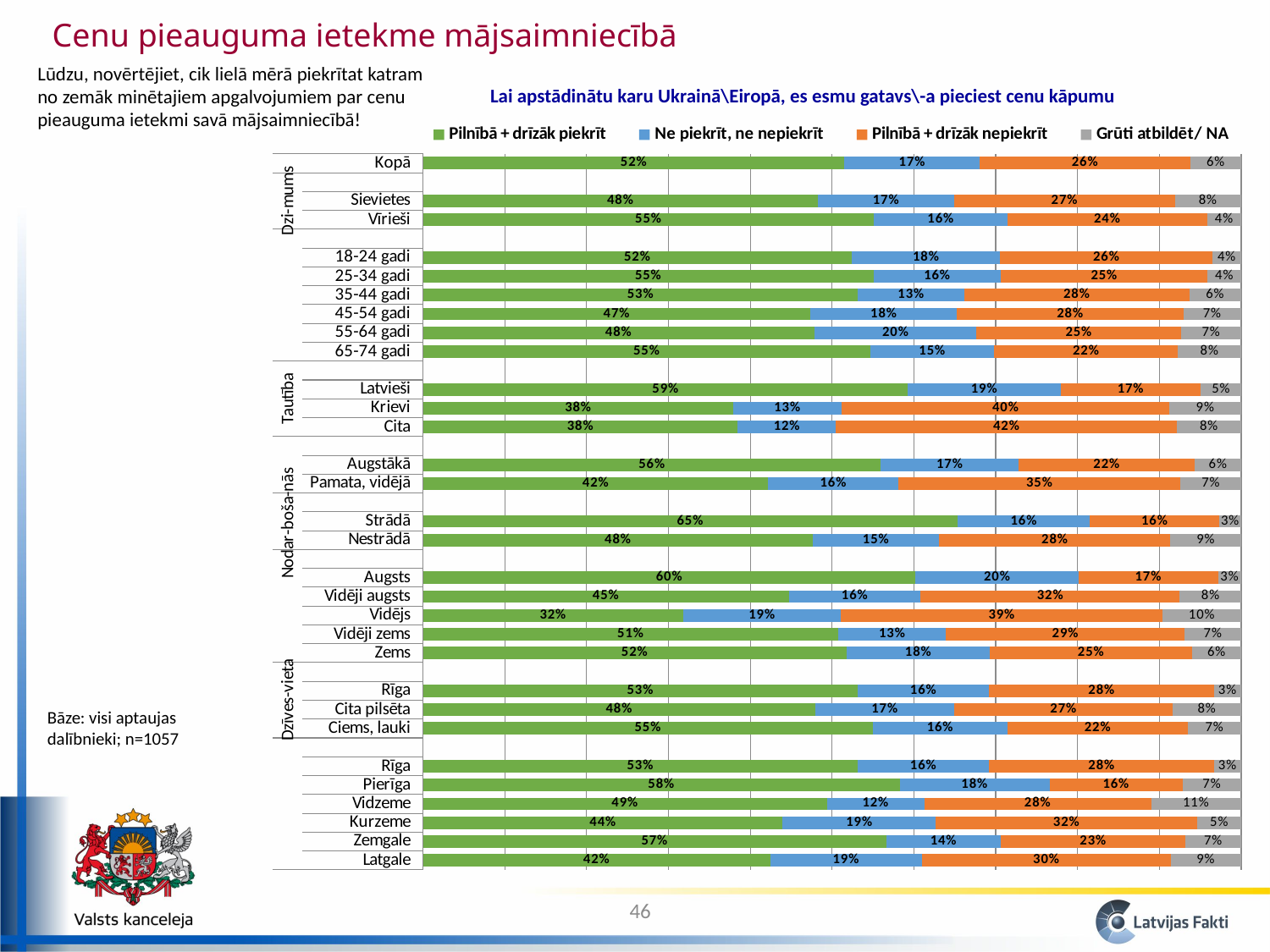
What type of chart is shown on the slide? Stacked bar chart Which category has the highest value for 'Pilnībā + drīzāk nepiekrīt'? Cita What is the title of the chart? Lai apstādinātu karu Ukrainā\Eiropā, es esmu gatavs\-a pieciest cenu kāpumu What is the value of 'Grūti atbildēt/ NA' for Vidzeme? 11% Which category has the highest value for 'Pilnībā + drīzāk piekrīt'? Strādā What is the value of 'Ne piekrīt, ne nepiekrīt' for Augsts? 20% What is the difference between the 'Pilnībā + drīzāk piekrīt' values for Latvieši and Krievi? 21% What is the value of 'Pilnībā + drīzāk piekrīt' for Kopā? 52% What is the value of 'Pilnībā + drīzāk nepiekrīt' for Krievi? 40% Which category has the lowest value for 'Pilnībā + drīzāk piekrīt'? Vidējs How many series does the legend list? 4 Which has a larger 'Pilnībā + drīzāk piekrīt' value, Sievietes or Vīrieši? Vīrieši